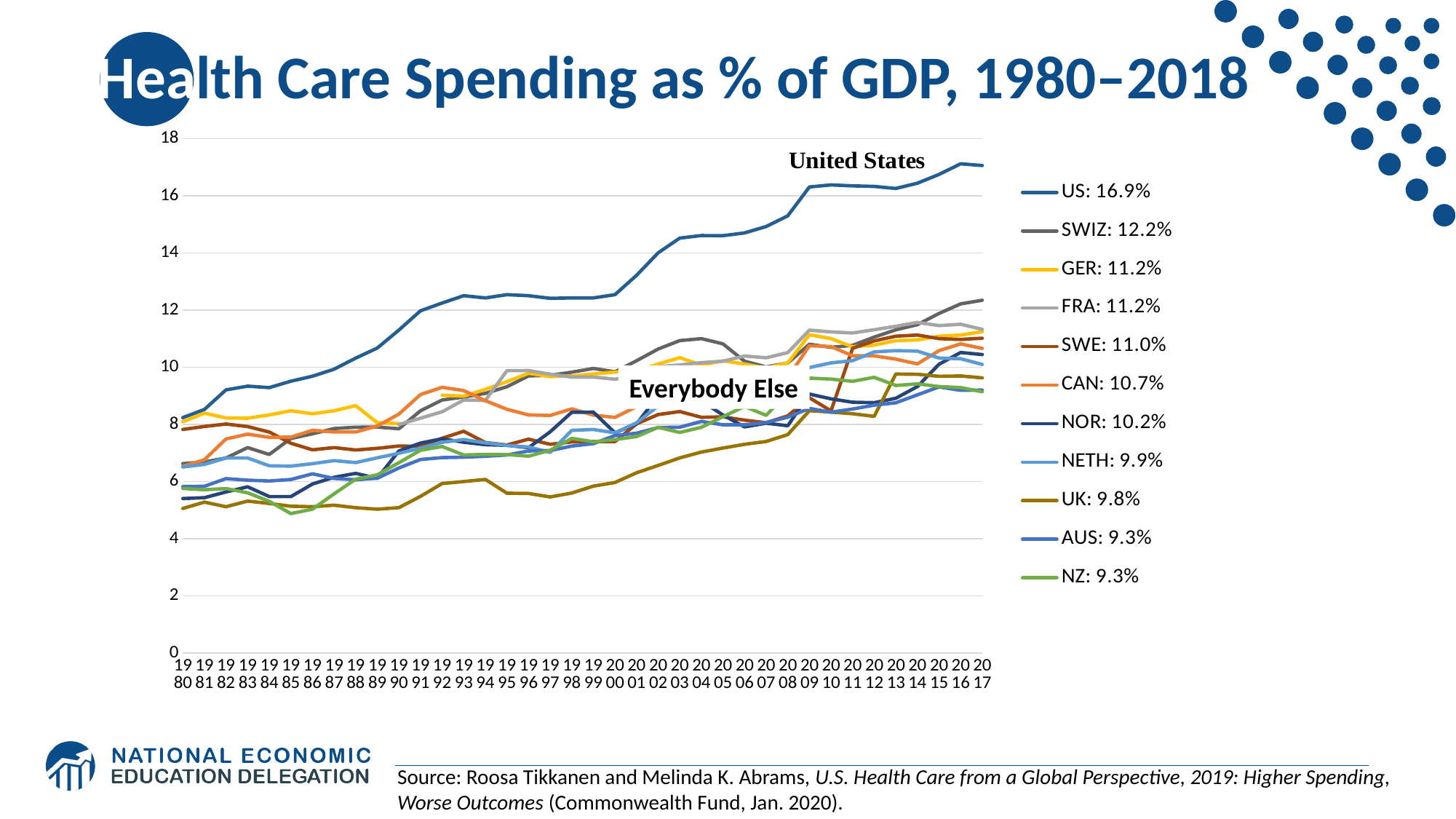
What are the two text annotations placed on the plot area? United States and Everybody Else Does the US line rise or fall from 1980 to 2017? rises Which country has the highest value in the legend? US What kind of chart is shown on the slide? line chart What value does the legend give for the US? 16.9% What value does the legend give for the UK? 9.8% What value does the legend give for SWIZ? 12.2% Which has the larger legend value, CAN or NOR? CAN What is the difference between the legend values for the US and SWIZ? 4.7 percentage points How many series does the legend list? 11 Is the value for the US line in 1980 greater or less than 10? less Is the value for the US line in 2017 greater or less than 16? greater